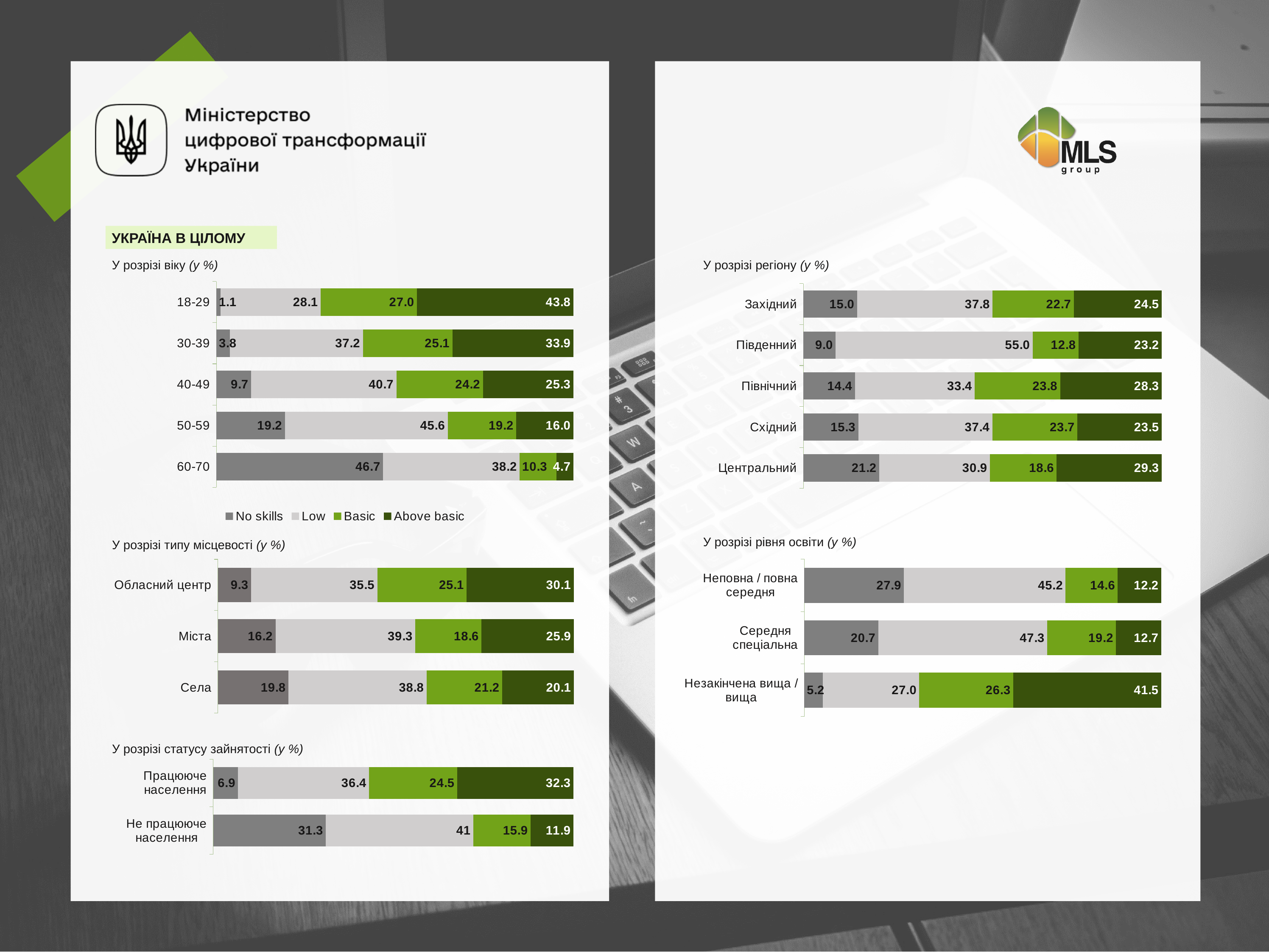
In the chart 'У розрізі регіону (у %)', what is the 'Low' value for Південний? 55.0 In the chart 'У розрізі віку (у %)', what is the 'Above basic' value for the 18-29 age group? 43.8 In the chart 'У розрізі типу місцевості (у %)', how many locality categories are shown? 3 In the chart 'У розрізі рівня освіти (у %)', what is the 'Above basic' value for 'Незакінчена вища / вища'? 41.5 In the chart 'У розрізі віку (у %)', what is the difference between the 'Low' values for 50-59 and 18-29? 17.5 What type of chart is used for 'У розрізі регіону (у %)'? Stacked bar chart In the chart 'У розрізі статусу зайнятості (у %)', what is the 'No skills' value for 'Не працююче населення'? 31.3 In the chart 'У розрізі віку (у %)', which age group has the highest 'No skills' value? 60-70 In the chart 'У розрізі регіону (у %)', which region has the lowest 'Basic' value? Південний In the chart 'У розрізі типу місцевості (у %)', which is larger: the 'Above basic' value for Обласний центр or for Села? Обласний центр How many series does the legend below the 'У розрізі віку (у %)' chart list? 4 In the chart 'У розрізі регіону (у %)', which region has the highest 'Above basic' value? Центральний